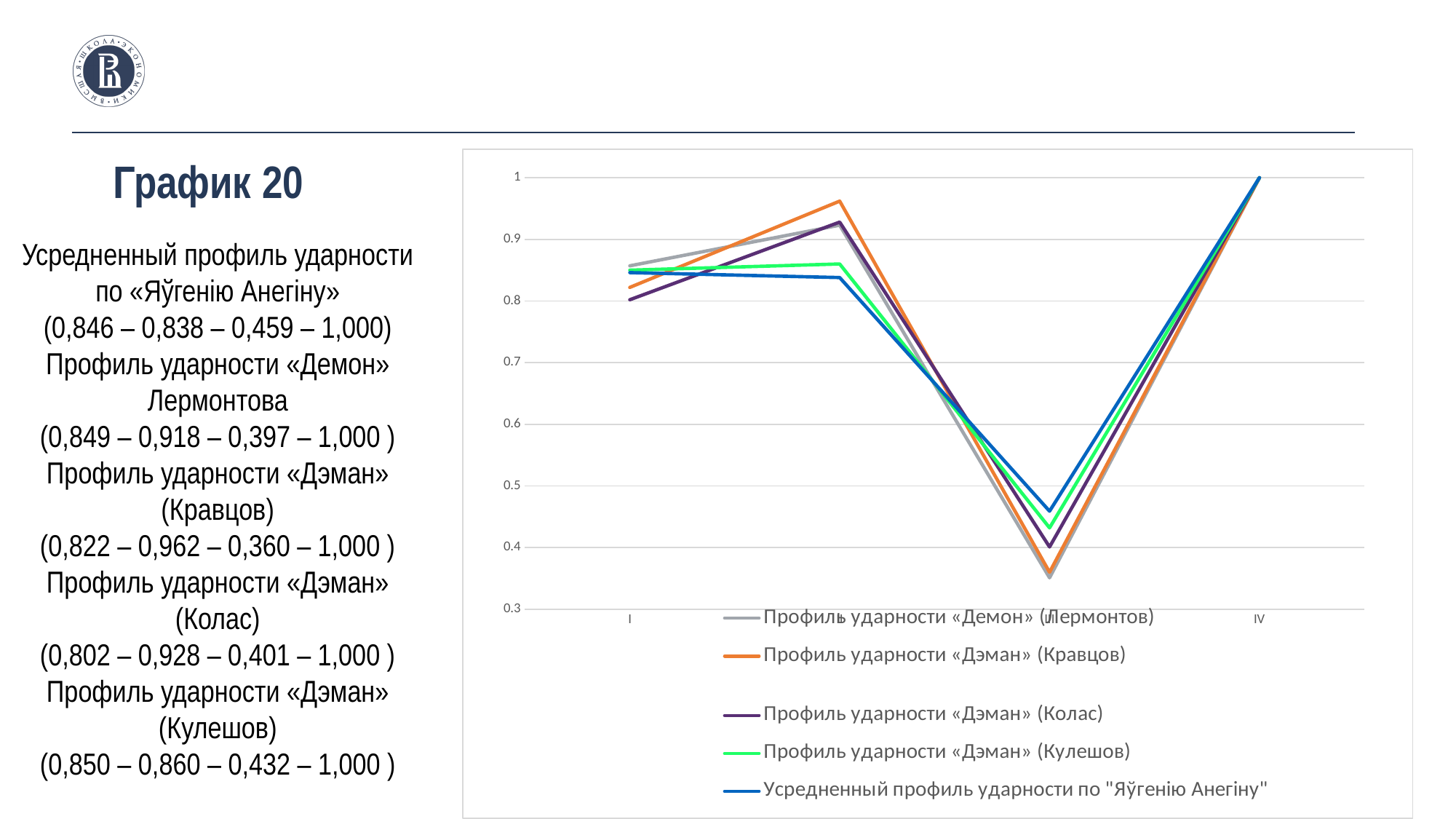
What colour is the line for Усредненный профиль ударности по «Яўгенію Анегіну» in the legend? blue At point II, which is larger: Профиль ударности «Дэман» (Кравцов) or Профиль ударности «Дэман» (Кулешов)? Профиль ударности «Дэман» (Кравцов) Is the value of Усредненный профиль ударности по «Яўгенію Анегіну» at point III greater or less than 0.5? less Which series has the highest value at point II? Профиль ударности «Дэман» (Кравцов) Is the value of Профиль ударности «Дэман» (Кравцов) at point II greater or less than 0.9? greater How many series does the chart legend list? 5 Is the value of Профиль ударности «Дэман» (Колас) at point I greater or less than 0.85? less Do the values of all series rise or fall from point II to point III? fall What kind of chart is shown on the slide? line chart What value do all the series reach at point IV? 1 How many points along the x axis does each line have? 4 Which series has the lowest value at point I? Профиль ударности «Дэман» (Колас)